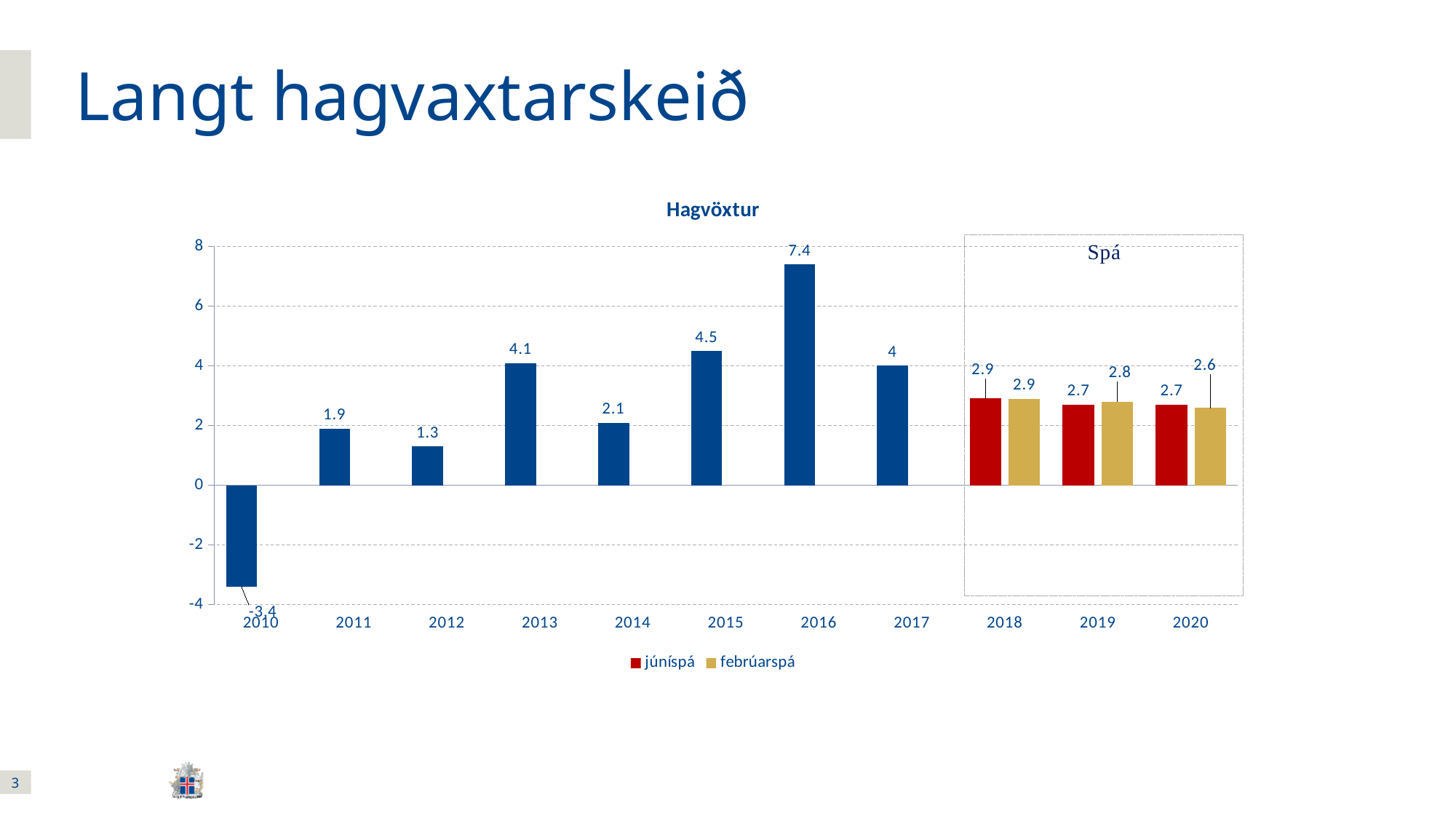
What is the febrúarspá value for 2020? 2.6 Which year has the lowest value in the Hagvöxtur chart? 2010 Which year has the highest value in the Hagvöxtur chart? 2016 What is the difference between the values for 2016 and 2015? 2.9 How many series does the legend list? 2 What is the value for 2016 in the Hagvöxtur chart? 7.4 How many years are shown on the x axis of the Hagvöxtur chart? 11 Which is larger, the value for 2013 or the value for 2014? 2013 Is the value for 2017 greater or less than 2? greater What kind of chart is shown on the slide? bar chart What is the value for 2010 in the Hagvöxtur chart? -3.4 What is the júníspá value for 2019? 2.7